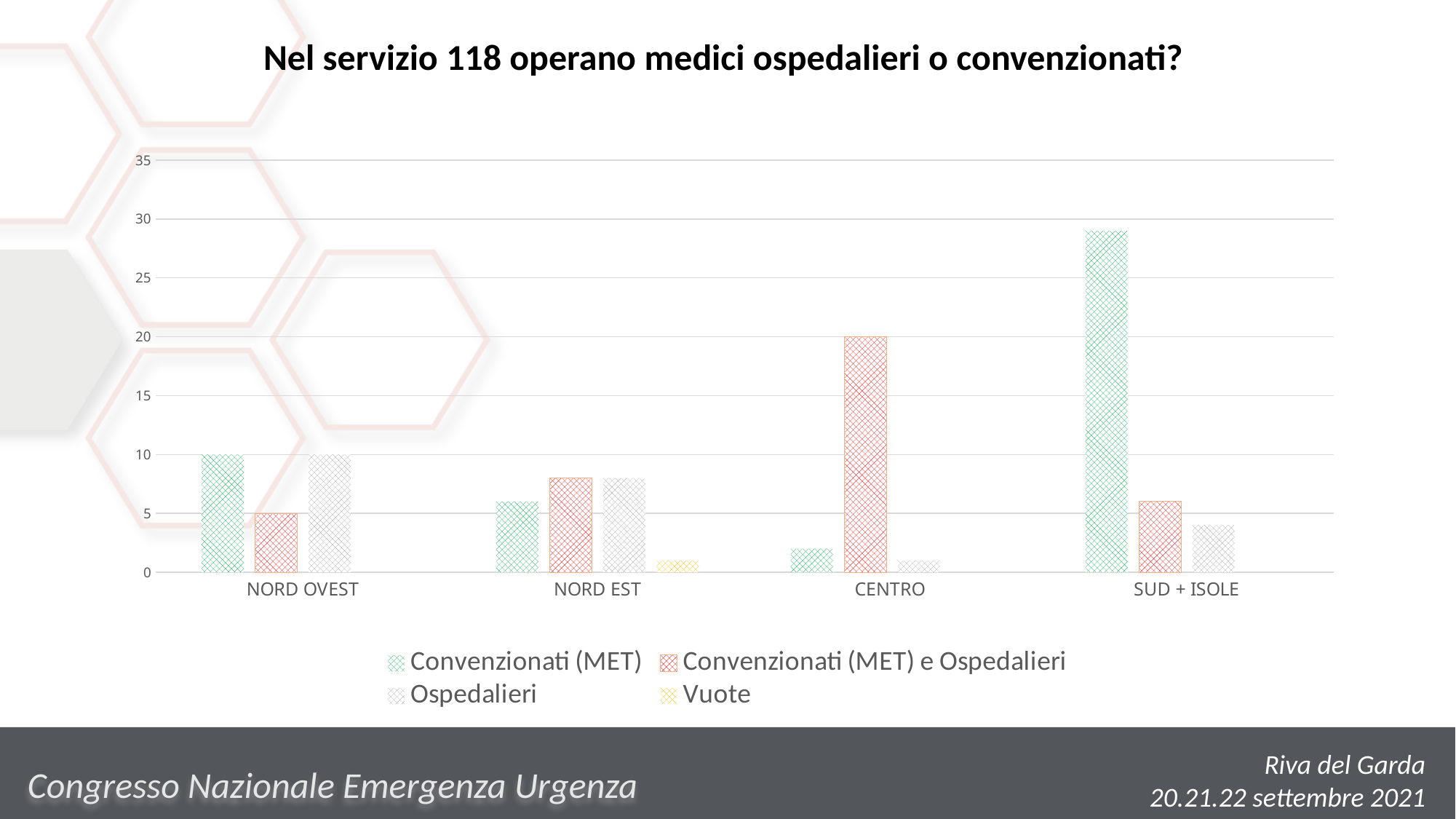
Is the value for Convenzionati (MET) in SUD + ISOLE greater or less than 25? greater Which category has the highest value for Convenzionati (MET)? SUD + ISOLE What type of chart is shown on the slide? bar chart What is the value for Convenzionati (MET) in NORD OVEST? 10 What is the value for Convenzionati (MET) e Ospedalieri in CENTRO? 20 How many regional categories are shown on the x axis? 4 Is the value for Ospedalieri in SUD + ISOLE greater or less than 5? less What is the value for Convenzionati (MET) e Ospedalieri in NORD OVEST? 5 How many series does the legend list? 4 What is the title of the chart? Nel servizio 118 operano medici ospedalieri o convenzionati? Which is larger in NORD EST: Convenzionati (MET) or Convenzionati (MET) e Ospedalieri? Convenzionati (MET) e Ospedalieri Which category has the highest value for Convenzionati (MET) e Ospedalieri? CENTRO